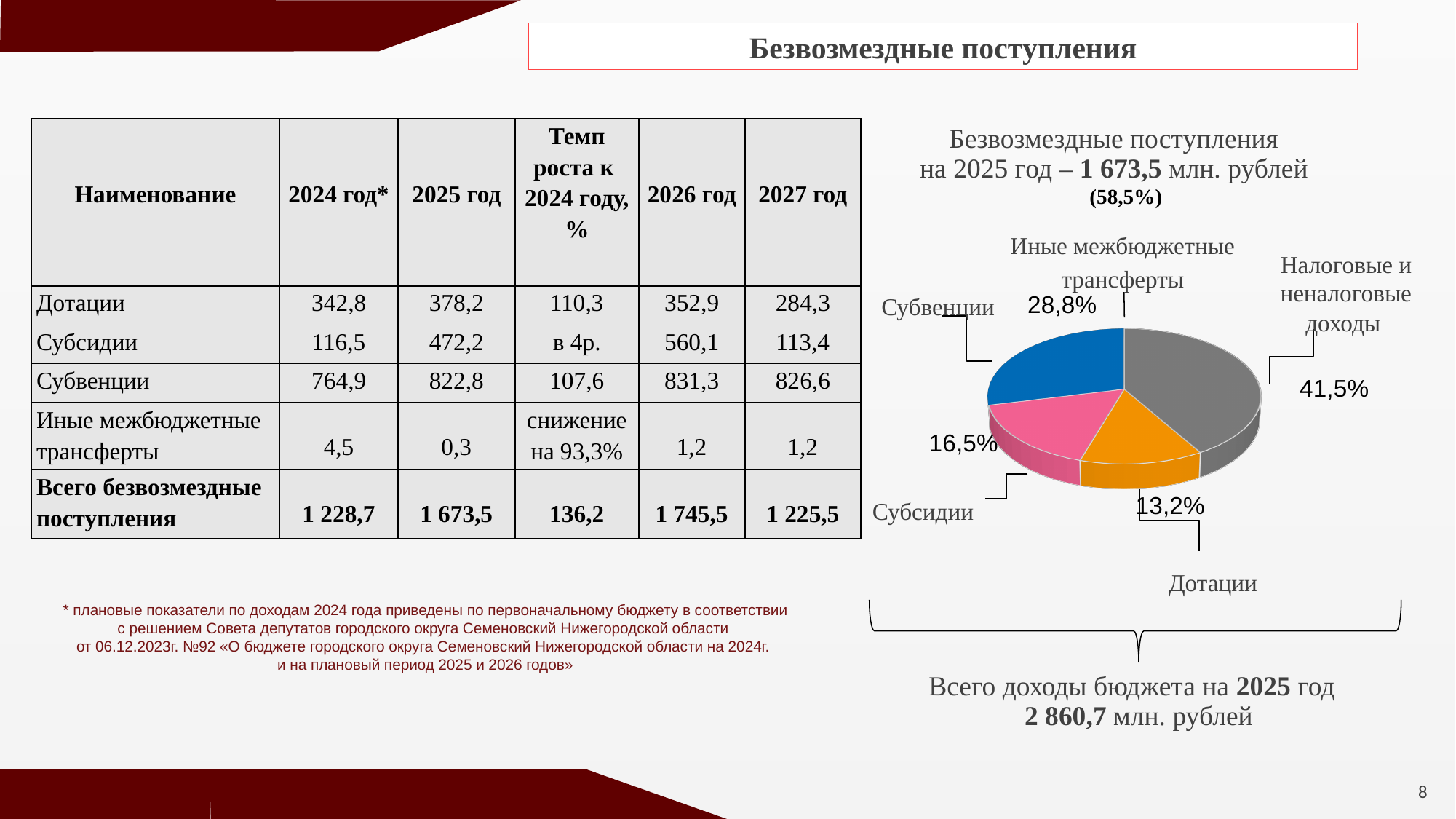
Which slice of the pie chart is the largest? Налоговые и неналоговые доходы According to the text below the pie chart, what is the total budget income for 2025? 2 860,7 млн. рублей In the pie chart, what share is shown for Субсидии? 16,5% What kind of chart is shown on the right side of the slide? pie chart In the pie chart, what share is shown for Налоговые и неналоговые доходы? 41,5% In the pie chart, what share is shown for Дотации? 13,2% What colour is the Субсидии slice in the pie chart? pink What colour is the Дотации slice in the pie chart? orange In the pie chart, by how many percentage points does the share for Субсидии exceed the share for Дотации? 3,3 In the pie chart, which is larger: the share for Налоговые и неналоговые доходы or the share for Субвенции? Налоговые и неналоговые доходы According to the chart heading, what is the amount of безвозмездные поступления for 2025? 1 673,5 млн. рублей In the pie chart, which is larger: the share for Субсидии or the share for Дотации? Субсидии